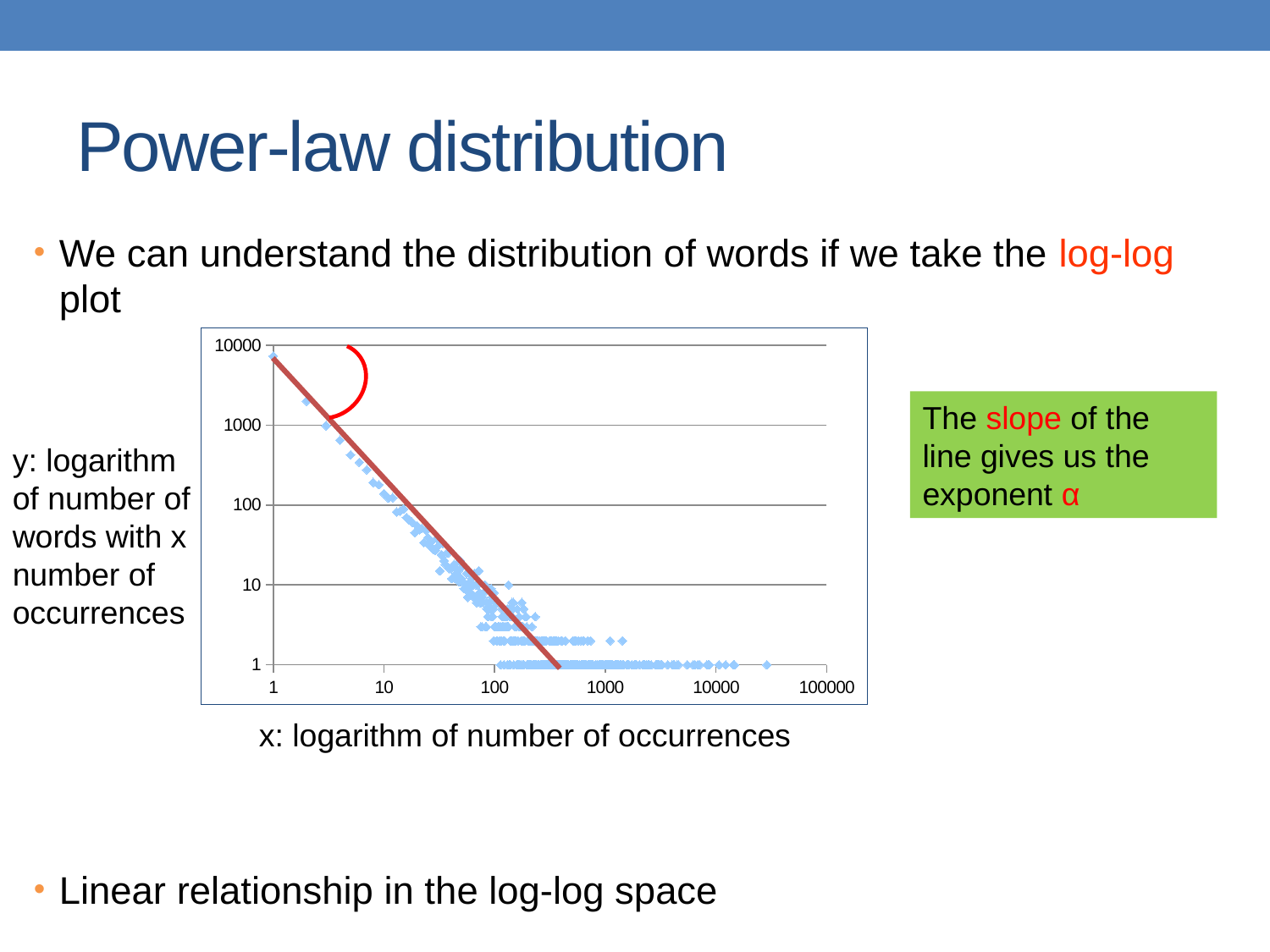
What is the label of the x axis of the chart? x: logarithm of number of occurrences As the number of occurrences on the x axis increases, do the plotted values rise or fall? fall Is the plotted value at x = 10000 greater or less than 10? less What is the largest tick value shown on the x axis of the chart? 100000 Is the plotted value at x = 1 greater or less than 1000? greater How many tick values are labelled on the y axis of the chart? 5 How many tick values are labelled on the x axis of the chart? 6 What kind of chart is shown on the slide? scatter plot